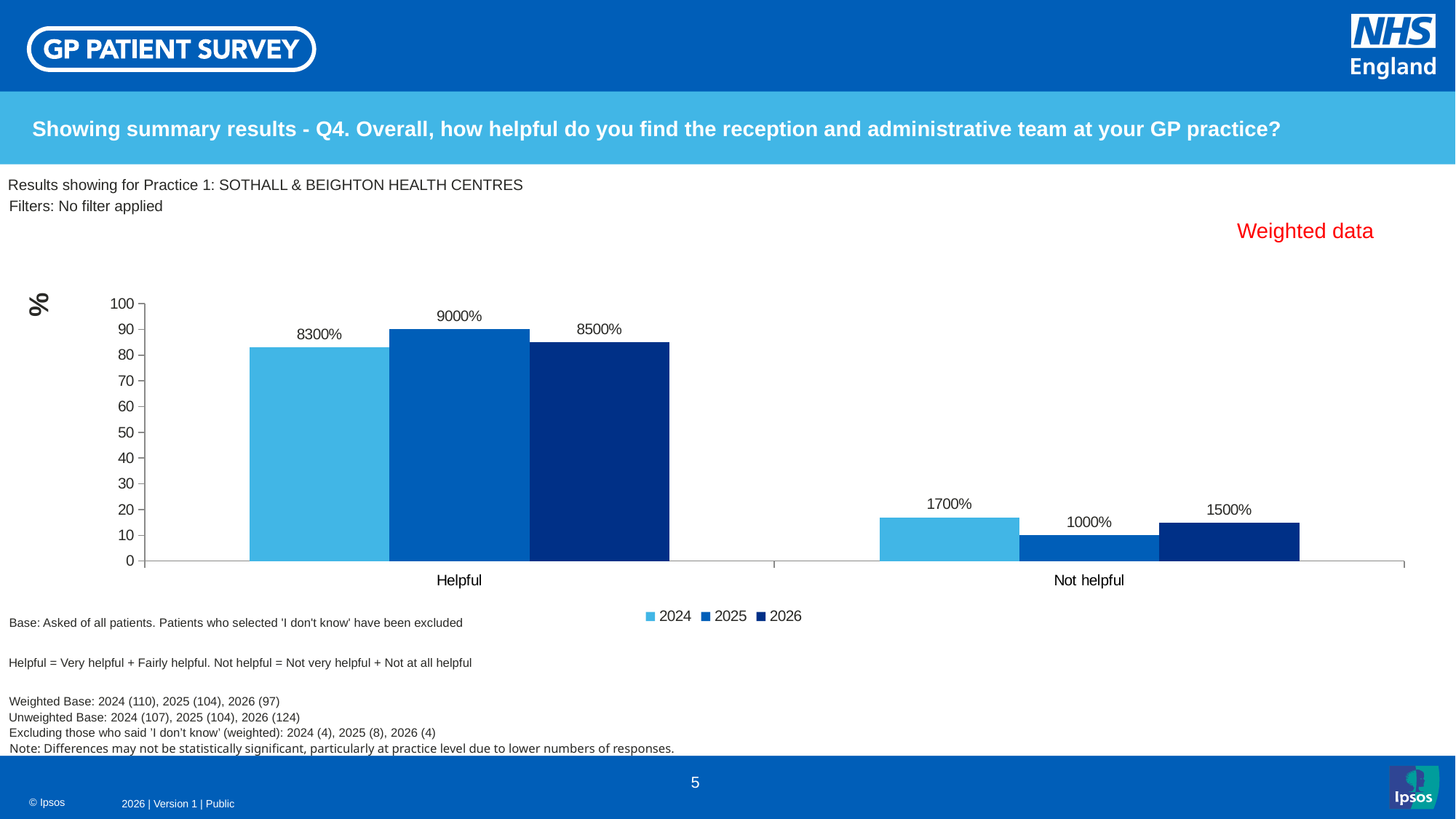
What kind of chart is shown on the slide? Bar chart Which year has the lowest bar in the Not helpful category? 2025 How many categories are shown on the x axis? 2 How many series does the legend list? 3 Which year has the highest bar in the Helpful category? 2025 What is the data label shown for 2024 in the Not helpful category? 1700% Is the 2024 bar for Not helpful greater or less than 20 on the axis? less What is the data label shown for 2025 in the Not helpful category? 1000% What is the data label shown for 2025 in the Helpful category? 9000% What is the data label shown for 2026 in the Helpful category? 8500% In the Helpful category, which is larger: the 2024 bar or the 2026 bar? 2026 Is the 2024 bar for Helpful greater or less than 80 on the axis? greater